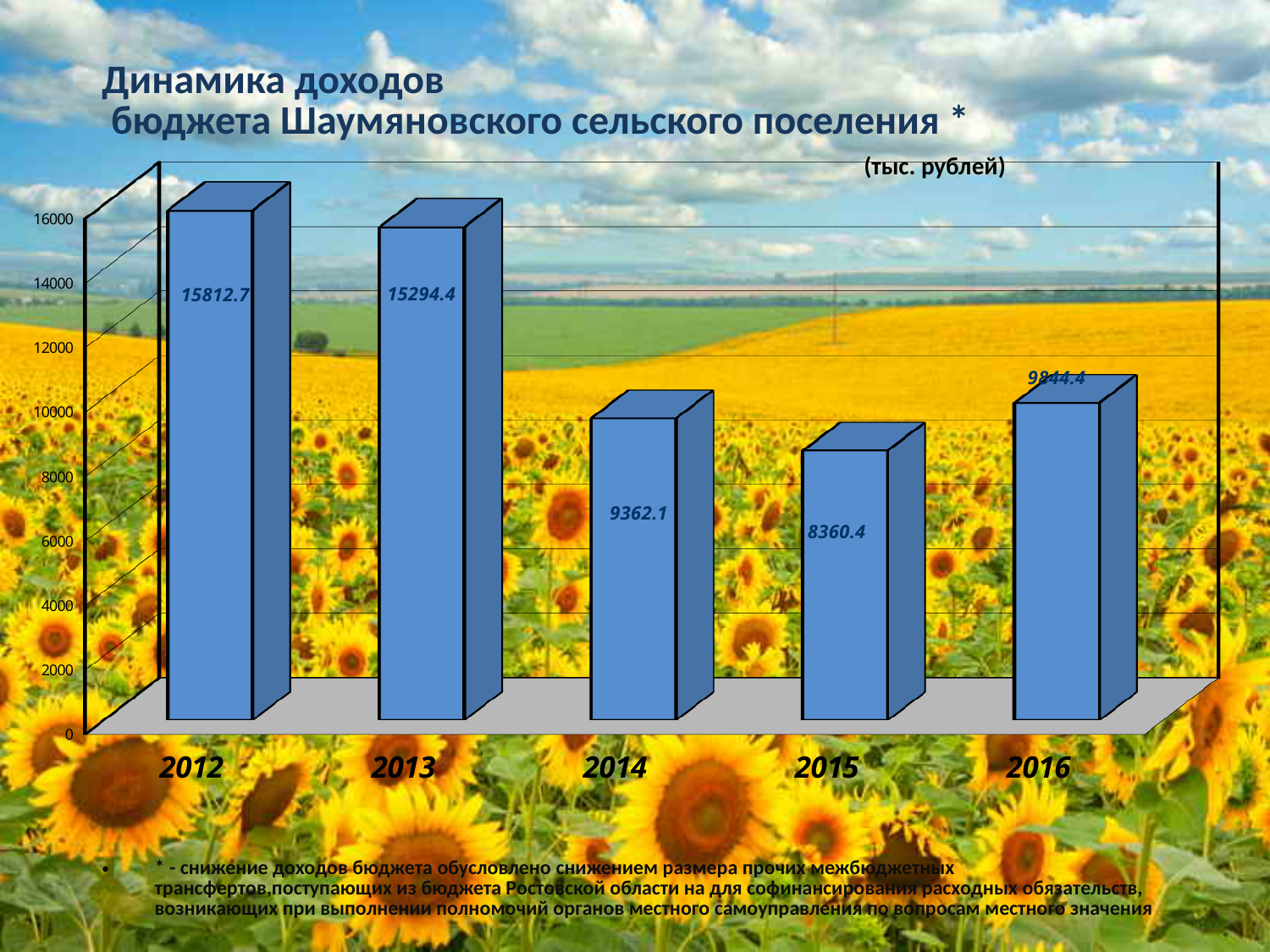
What is the difference between the values for 2012 and 2013? 518.3 What is the value for 2012? 15812.7 How many years are shown on the x axis? 5 What is the value for 2015? 8360.4 Is the value for 2016 greater or less than 8000? greater What is the value for 2013? 15294.4 Which year has the highest value? 2012 Which year has the lowest value? 2015 Which is larger, the value for 2013 or the value for 2014? 2013 What is the difference between the values for 2014 and 2015? 1001.7 What kind of chart is shown on the slide? bar chart What is the value for 2014? 9362.1